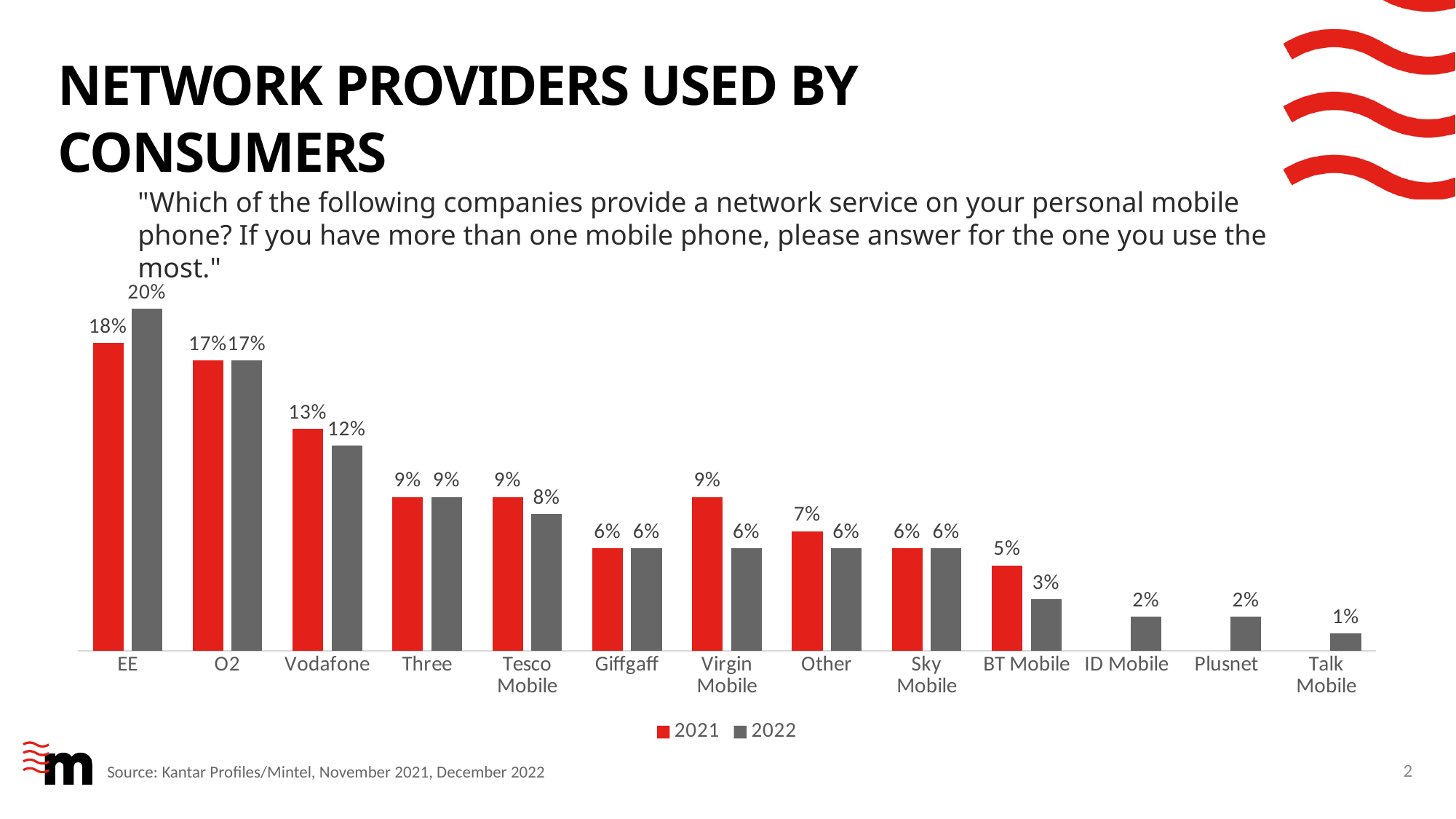
What is the difference between the 2021 and 2022 values for Virgin Mobile? 3% What percentage of consumers used EE in 2022? 20% Which network provider had the highest value in 2022? EE Which colour represents the 2021 series in the chart? Red What is the difference between the 2021 and 2022 values for EE? 2% Which is larger for Tesco Mobile, the 2021 value or the 2022 value? 2021 What kind of chart is shown on the slide? Bar chart How many series does the legend list? 2 How many network provider categories are shown on the x axis? 13 Which network provider had the lowest value in 2022? Talk Mobile What was the value for BT Mobile in 2022? 3% What was the value for Vodafone in 2021? 13%